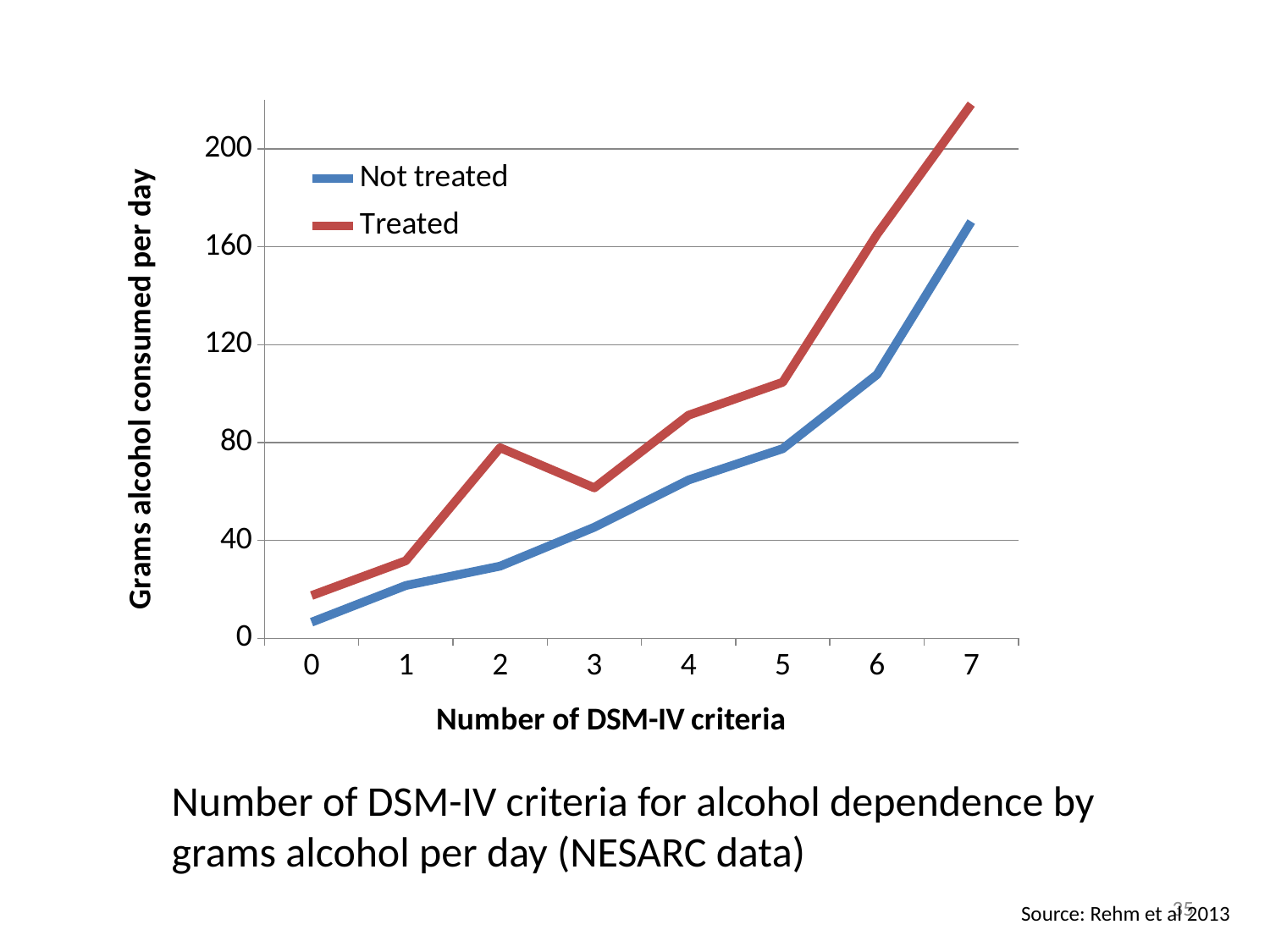
Is the value for Treated at 3 DSM-IV criteria greater or less than 80? less How many points along the x axis (number of DSM-IV criteria) are plotted for each series? 8 At which number of DSM-IV criteria is the Not treated series lowest? 0 Is the value for Not treated at 7 DSM-IV criteria greater or less than 200? less Is the value for Treated at 5 DSM-IV criteria greater or less than 80? greater At which number of DSM-IV criteria does the Treated series reach its highest value? 7 How many series does the legend list? 2 Does the Not treated series rise or fall as the number of DSM-IV criteria increases? rise At 7 DSM-IV criteria, which series has the larger value, Treated or Not treated? Treated What kind of chart is shown on the slide? line chart